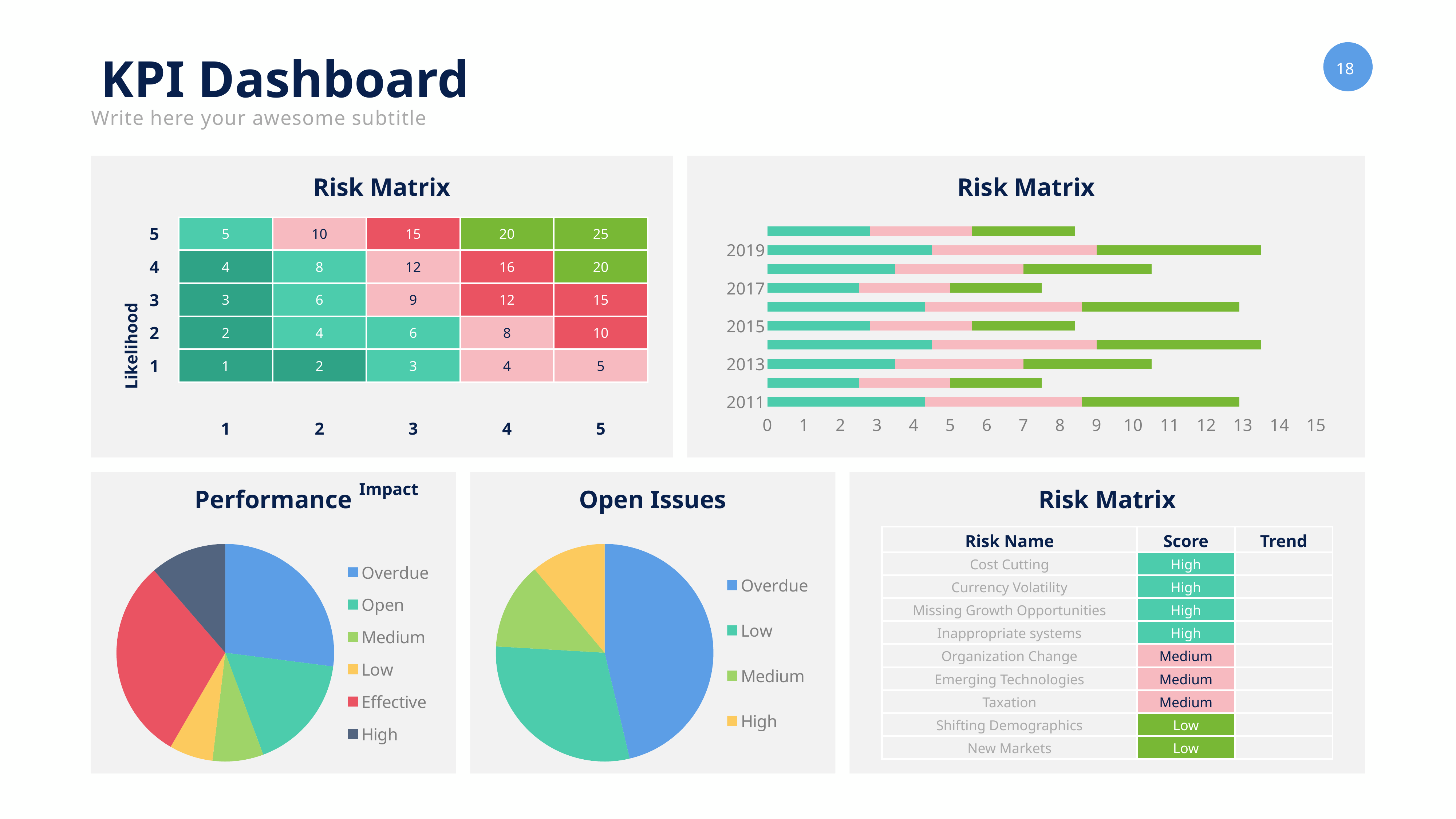
What kind of chart is the 'Performance' chart? pie chart What kind of chart is the top-right 'Risk Matrix' chart? stacked bar chart In the top-right 'Risk Matrix' bar chart, is the total length of the 2019 bar greater or less than 12? greater In the top-right 'Risk Matrix' bar chart, how many bars are plotted? 10 In the 'Performance' pie chart, which category has the smallest slice? Low How many entries does the legend of the 'Performance' pie chart list? 6 In the top-right 'Risk Matrix' bar chart, is the total length of the 2011 bar greater or less than 12? greater In the 'Open Issues' pie chart, which category has the largest slice? Overdue In the top-right 'Risk Matrix' bar chart, is the total length of the 2017 bar greater or less than 10? less How many entries does the legend of the 'Open Issues' pie chart list? 4 In the 'Performance' pie chart, which slice is larger, Open or Medium? Open